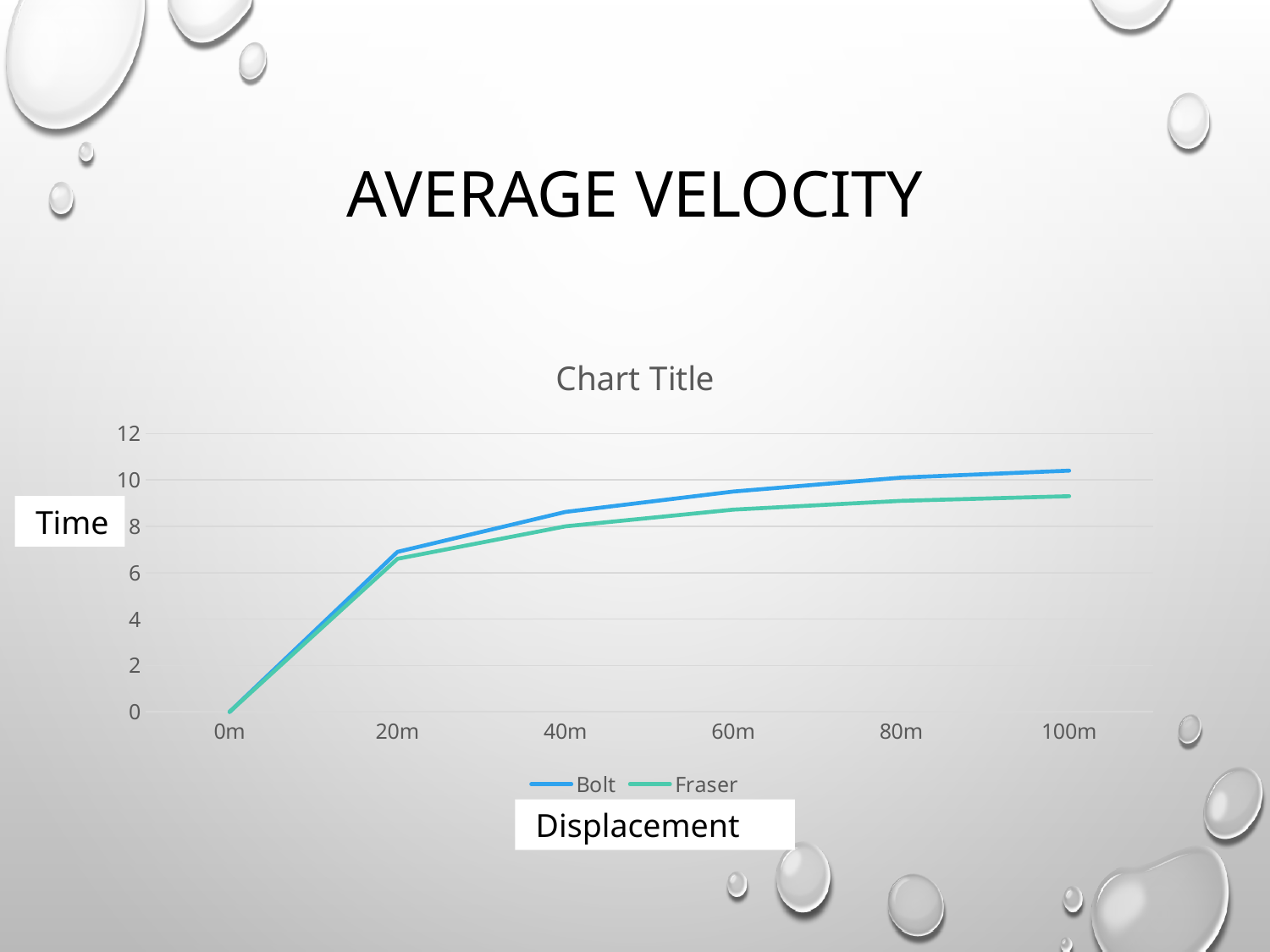
Is the value for Fraser at 100m greater or less than 10? less What kind of chart is shown on the slide? line chart Do the values for Bolt rise or fall as displacement increases from 0m to 100m? rise How many series does the legend list? 2 Is the value for Fraser at 60m greater or less than 8? greater At 100m, which series has the higher value, Bolt or Fraser? Bolt Is the value for Bolt at 20m greater or less than 6? greater How many displacement points are plotted along the x axis? 6 What is the label on the vertical axis of the chart? Time What is the value for Bolt at 0m? 0 Which series is drawn with the blue line? Bolt